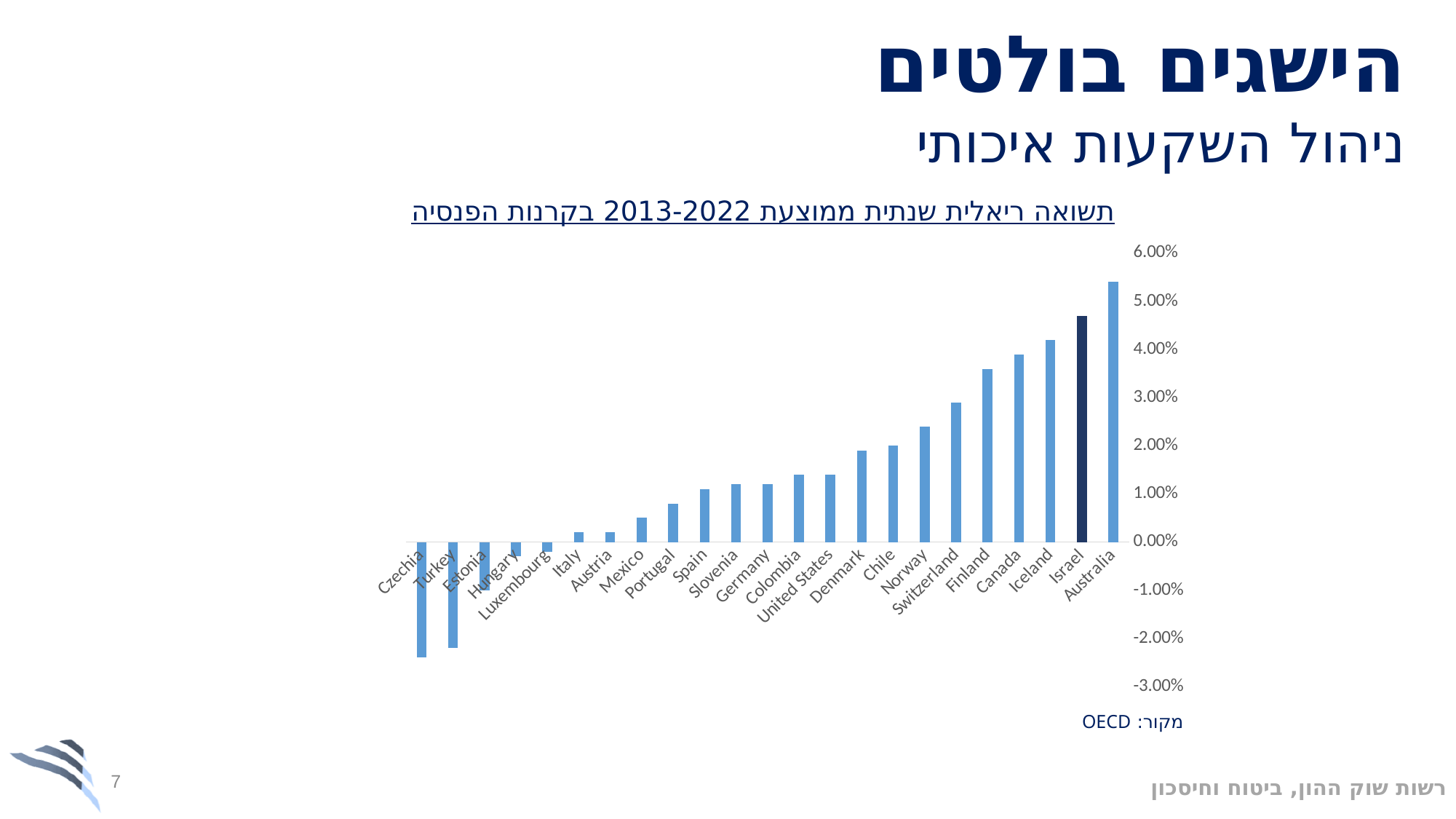
Is the value for Finland greater or less than 4.00%? less How many countries are shown on the chart? 23 Which has a larger value, Israel or Iceland? Israel What kind of chart is shown on the slide? Bar chart How many countries have a negative value on the chart? 5 Which country's bar is drawn in a darker colour than the others? Israel Is the value for Mexico greater or less than 1.00%? less Is the value for Australia greater or less than 5.00%? greater Which country has the highest average annual real return on the chart? Australia Do the values rise or fall moving from left to right along the x axis? Rise